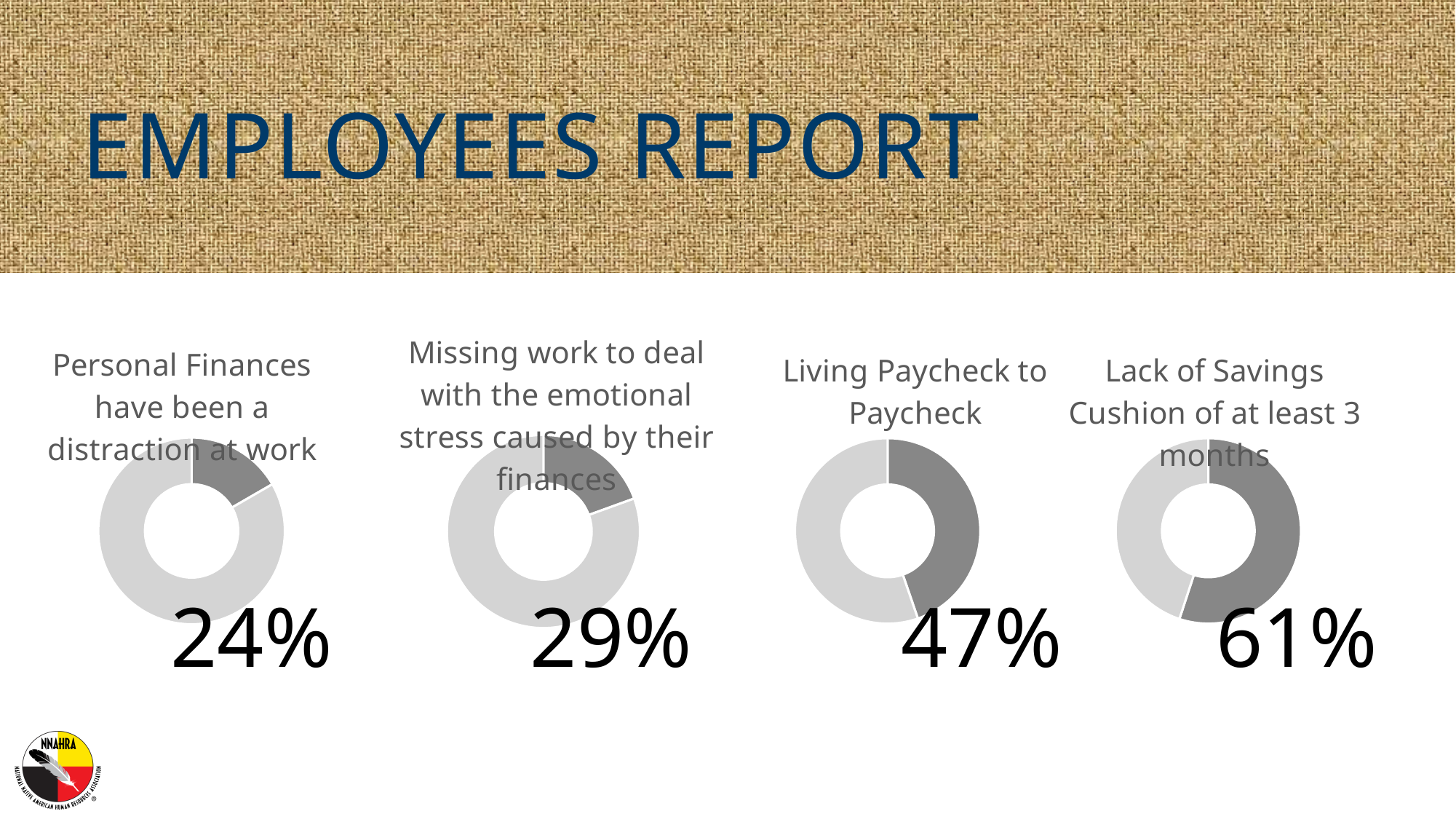
What percentage is shown for the 'Missing work to deal with the emotional stress caused by their finances' chart? 29% What percentage is shown for the 'Personal Finances have been a distraction at work' chart? 24% What percentage is shown for the 'Lack of Savings Cushion of at least 3 months' chart? 61% What is the difference between the 'Lack of Savings Cushion of at least 3 months' percentage and the 'Living Paycheck to Paycheck' percentage? 14% What is the difference between the 'Missing work to deal with the emotional stress caused by their finances' percentage and the 'Personal Finances have been a distraction at work' percentage? 5% What is the title of the slide? EMPLOYEES REPORT Which of the four charts shows the highest percentage? Lack of Savings Cushion of at least 3 months What percentage is shown for the 'Living Paycheck to Paycheck' chart? 47% Which of the four charts shows the lowest percentage? Personal Finances have been a distraction at work What kind of chart is used for 'Living Paycheck to Paycheck'? Donut chart Which is larger: the 'Living Paycheck to Paycheck' percentage or the 'Missing work to deal with the emotional stress caused by their finances' percentage? Living Paycheck to Paycheck How many donut charts are shown on the slide? 4